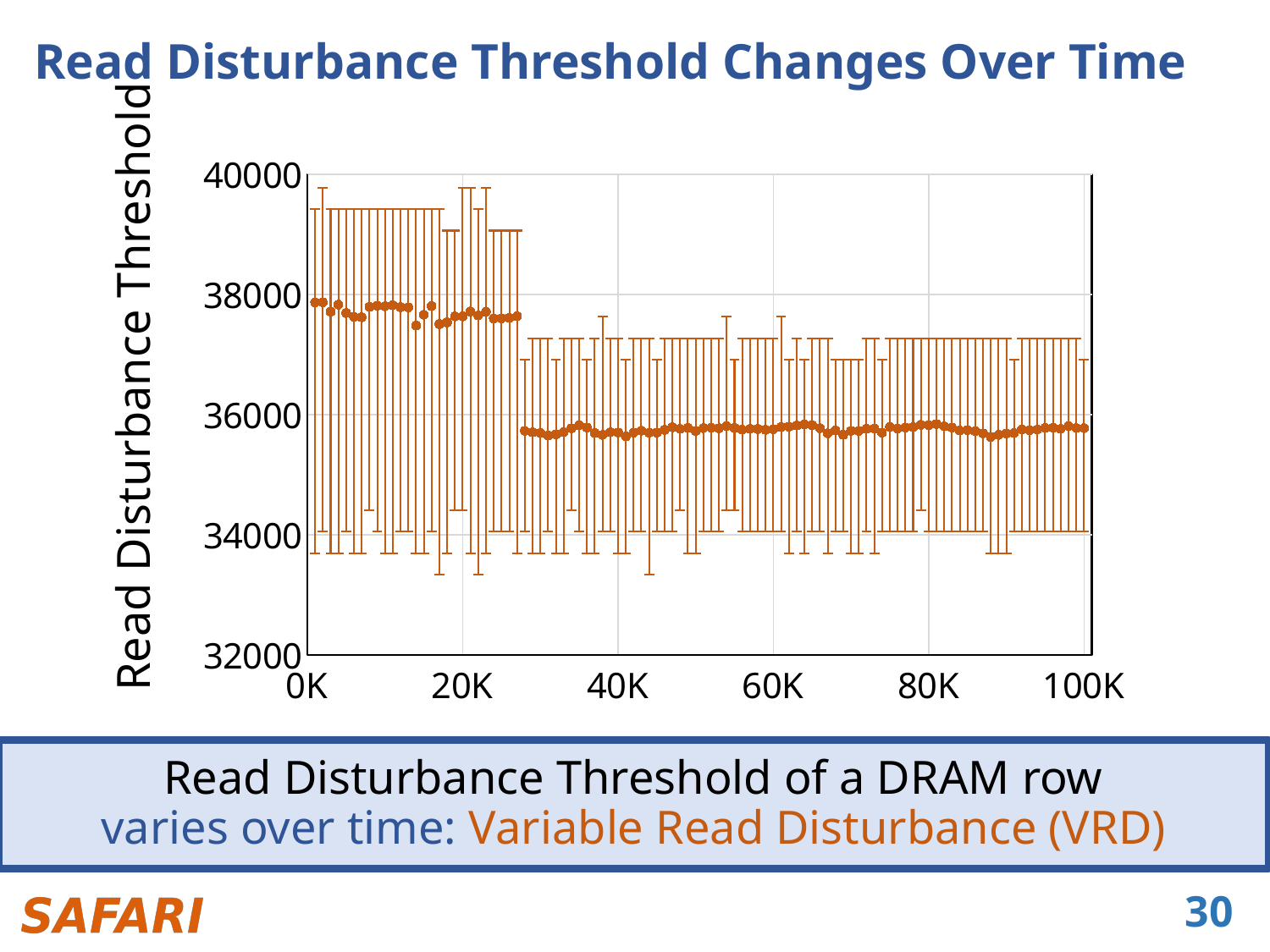
What kind of chart is shown on the slide? scatter chart with error bars Overall, do the Read Disturbance Threshold values rise or fall as time increases from 0K to 100K? fall Is the Read Disturbance Threshold at 10K greater or less than 36000? greater Between 40K and 100K, do the Read Disturbance Threshold values stay roughly flat, rise steadily, or fall steadily? stay roughly flat Which has the lower Read Disturbance Threshold, the point at 20K or the point at 90K? 90K What is the title of the chart? Read Disturbance Threshold Changes Over Time Which has the higher Read Disturbance Threshold, the point at 10K or the point at 60K? 10K Is the Read Disturbance Threshold at 80K greater or less than 38000? less What is the label of the y axis? Read Disturbance Threshold Is the Read Disturbance Threshold at 60K greater or less than 36000? less